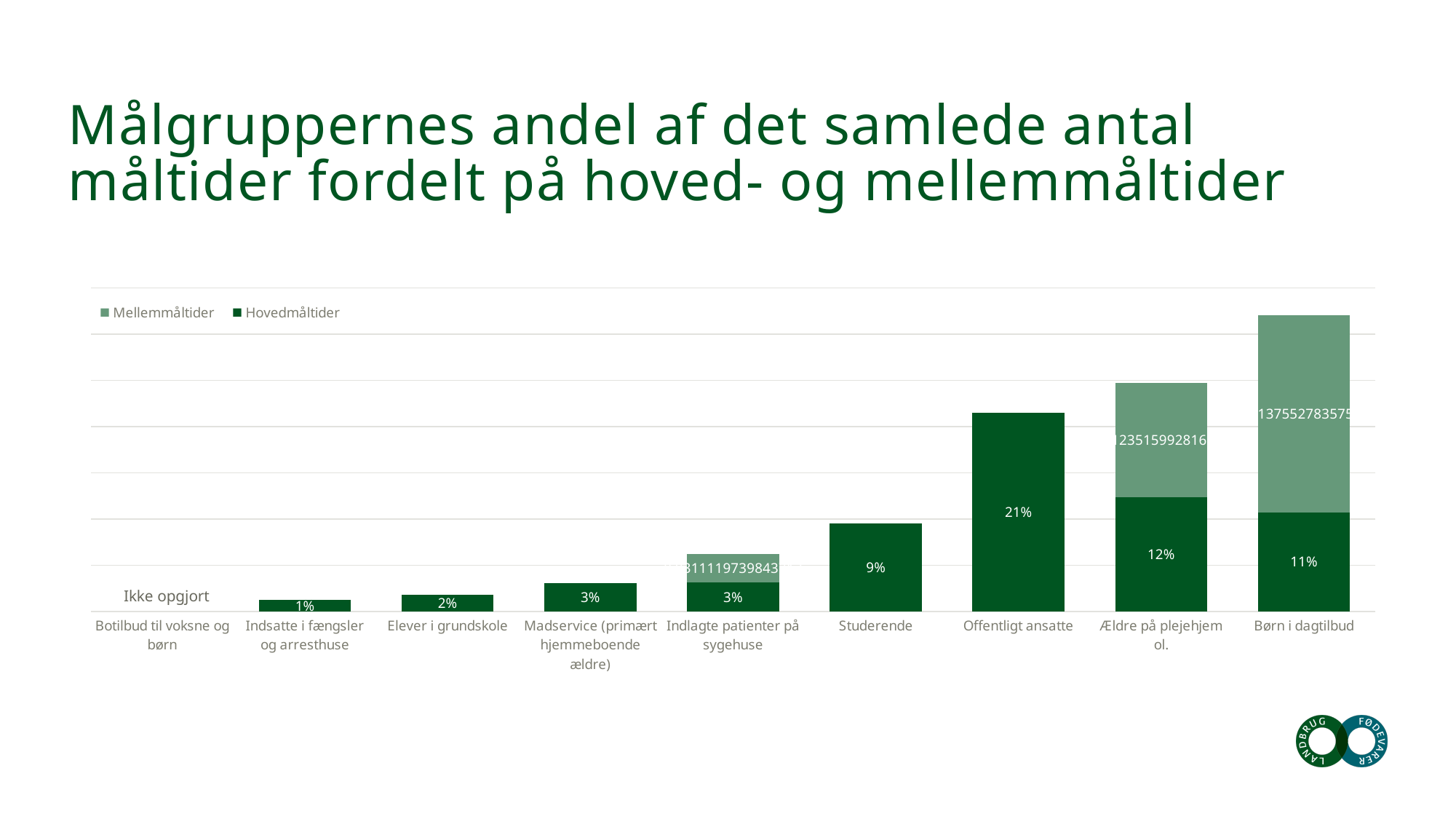
Which category has the tallest stacked bar overall? Børn i dagtilbud What is the Hovedmåltider value for Børn i dagtilbud? 11% What kind of chart is shown on the slide? Stacked bar chart What is the Hovedmåltider value for Studerende? 9% How many series does the legend list? 2 What is the difference between the Hovedmåltider values for Offentligt ansatte and Studerende? 12 percentage points What is the Hovedmåltider value for Ældre på plejehjem ol.? 12% What is the Hovedmåltider value for Indsatte i fængsler og arresthuse? 1% What is the Hovedmåltider value for Offentligt ansatte? 21% How many categories are shown on the x axis? 9 Which category has the highest Hovedmåltider value? Offentligt ansatte Which has the larger Hovedmåltider value, Ældre på plejehjem ol. or Børn i dagtilbud? Ældre på plejehjem ol.